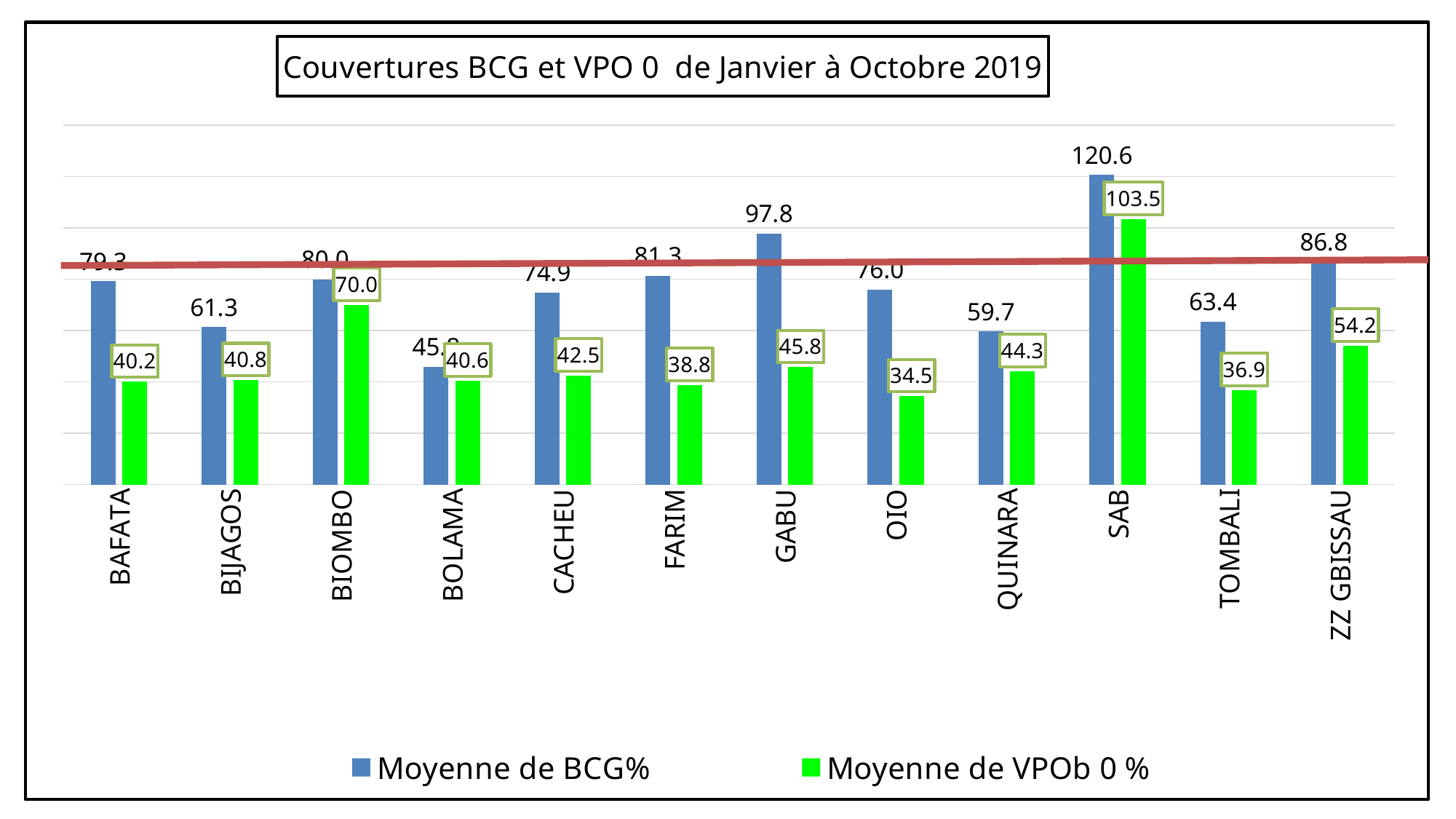
What is the title of the chart? Couvertures BCG et VPO 0 de Janvier à Octobre 2019 How many regions are shown on the x axis of the chart? 12 Which region has the lowest Moyenne de VPOb 0 % value? OIO What is the difference between the Moyenne de BCG% and Moyenne de VPOb 0 % values for GABU? 52.0 What is the difference between the Moyenne de BCG% and Moyenne de VPOb 0 % values for SAB? 17.1 Which has a higher Moyenne de BCG% value, GABU or ZZ GBISSAU? GABU What kind of chart is shown on the slide? Bar chart How many series does the legend list? 2 Which region has the highest Moyenne de BCG% value? SAB What is the Moyenne de VPOb 0 % value for OIO? 34.5 What is the Moyenne de VPOb 0 % value for BIOMBO? 70.0 What is the Moyenne de BCG% value for SAB? 120.6